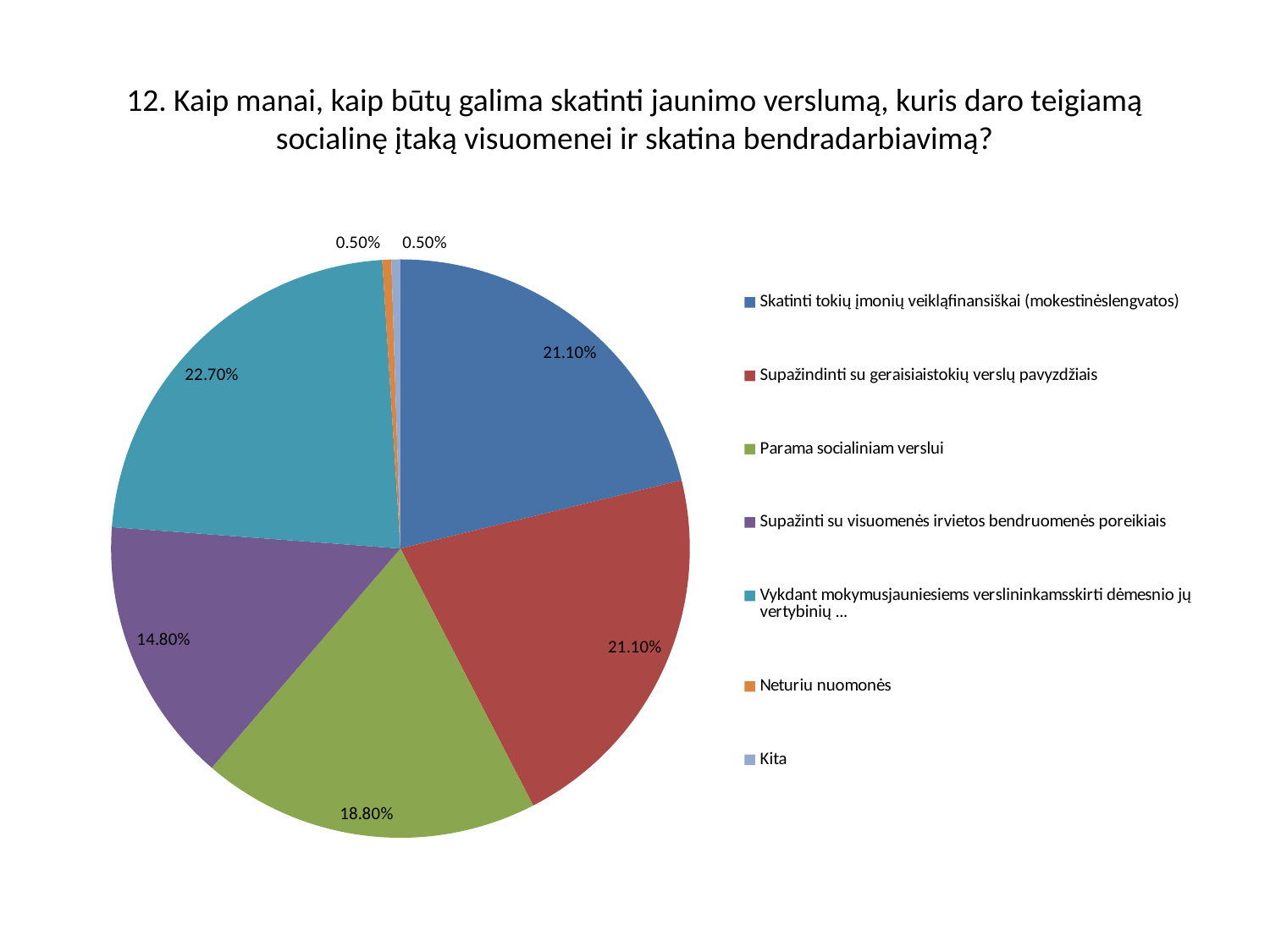
What is the value for "Neturiu nuomonės"? 0.50% What is the value for "Supažinti su visuomenės ir vietos bendruomenės poreikiais"? 14.80% What is the value for "Kita"? 0.50% What kind of chart is shown on the slide? pie chart How many entries does the legend list? 7 How many slices does the pie chart have? 7 Which category has the largest share of the pie? Vykdant mokymus jauniesiems verslininkams skirti dėmesnio jų vertybinių ... Which is larger: the share for "Parama socialiniam verslui" or the share for "Supažinti su visuomenės ir vietos bendruomenės poreikiais"? Parama socialiniam verslui What colour is the slice for "Neturiu nuomonės"? orange What is the smallest percentage shown on the pie chart? 0.50% What is the difference between the share for "Vykdant mokymus jauniesiems verslininkams skirti dėmesnio jų vertybinių ..." and the share for "Parama socialiniam verslui"? 3.90% What share of the pie is "Parama socialiniam verslui"? 18.80%